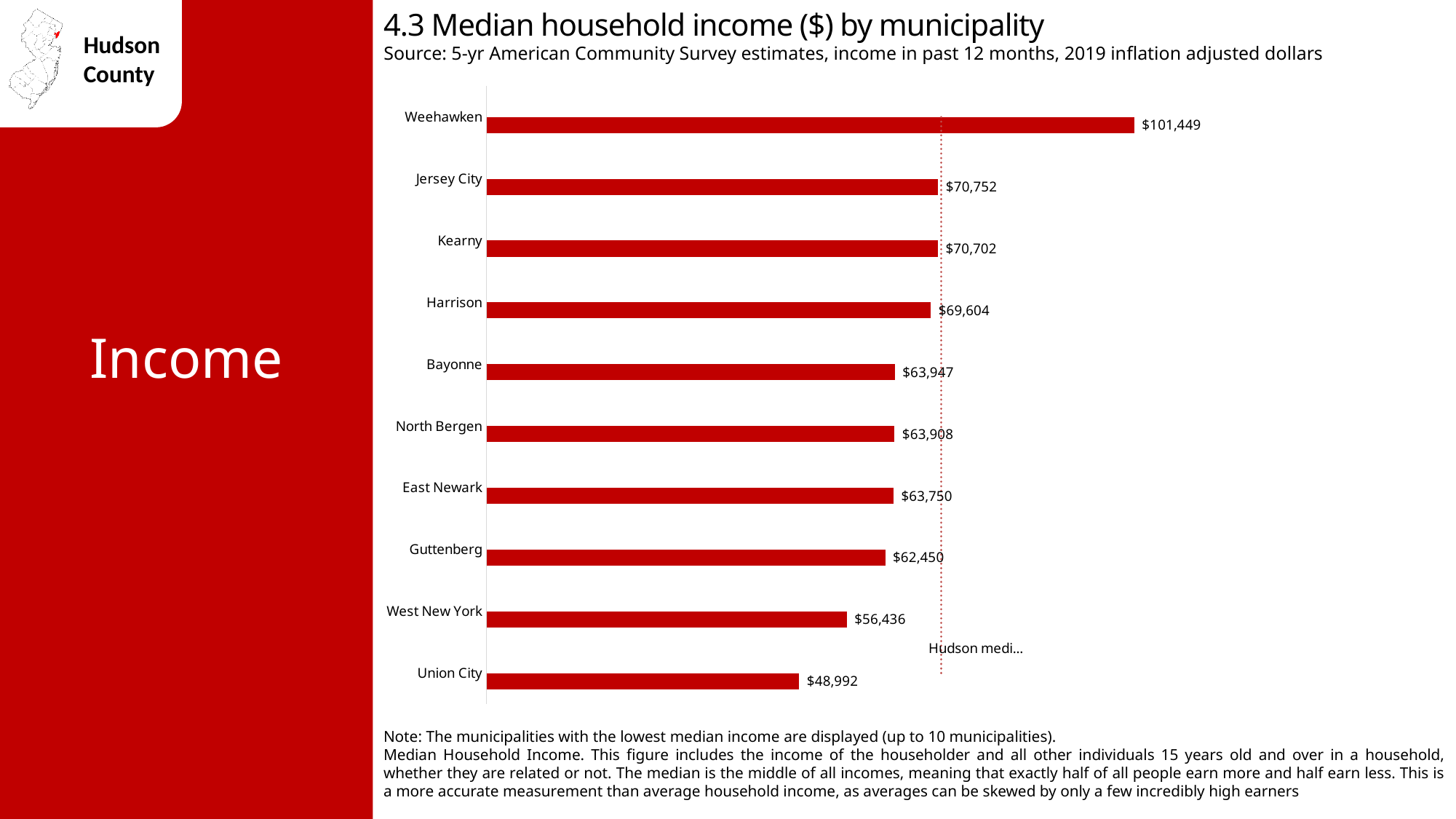
What kind of chart is shown on the slide? Bar chart How many municipalities are shown in the chart? 10 What is the median household income for Guttenberg? $62,450 What is the difference in median household income between Weehawken and Union City? $52,457 What is the median household income for Union City? $48,992 Which municipality has the lowest median household income? Union City What is the title of the chart? 4.3 Median household income ($) by municipality What is the median household income for Harrison? $69,604 What is the median household income for Weehawken? $101,449 Which municipality has the highest median household income? Weehawken What is the difference in median household income between Guttenberg and West New York? $6,014 Which has a higher median household income, Harrison or West New York? Harrison